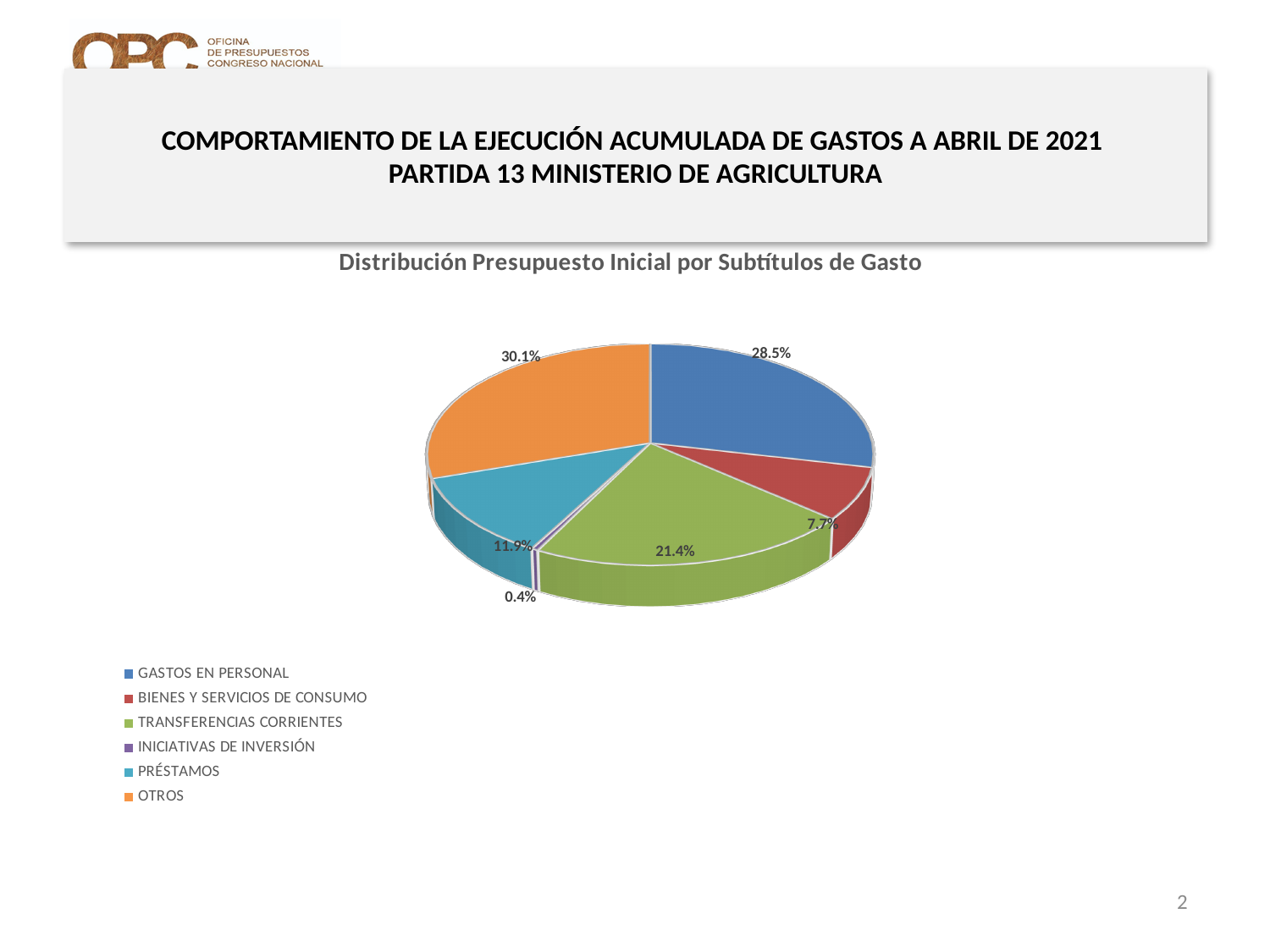
What kind of chart is shown on the slide? Pie chart What is the value shown for BIENES Y SERVICIOS DE CONSUMO? 7.7% Which category has the smallest share of the pie? INICIATIVAS DE INVERSIÓN What is the difference between the shares of OTROS and GASTOS EN PERSONAL? 1.6% What is the value shown for TRANSFERENCIAS CORRIENTES? 21.4% What share of the pie does GASTOS EN PERSONAL represent? 28.5% What is the value shown for PRÉSTAMOS? 11.9% Which is larger, the share for TRANSFERENCIAS CORRIENTES or the share for PRÉSTAMOS? TRANSFERENCIAS CORRIENTES How many categories does the legend list? 6 Which category has the largest share of the pie? OTROS What is the title of the chart? Distribución Presupuesto Inicial por Subtítulos de Gasto What share of the pie does OTROS represent? 30.1%